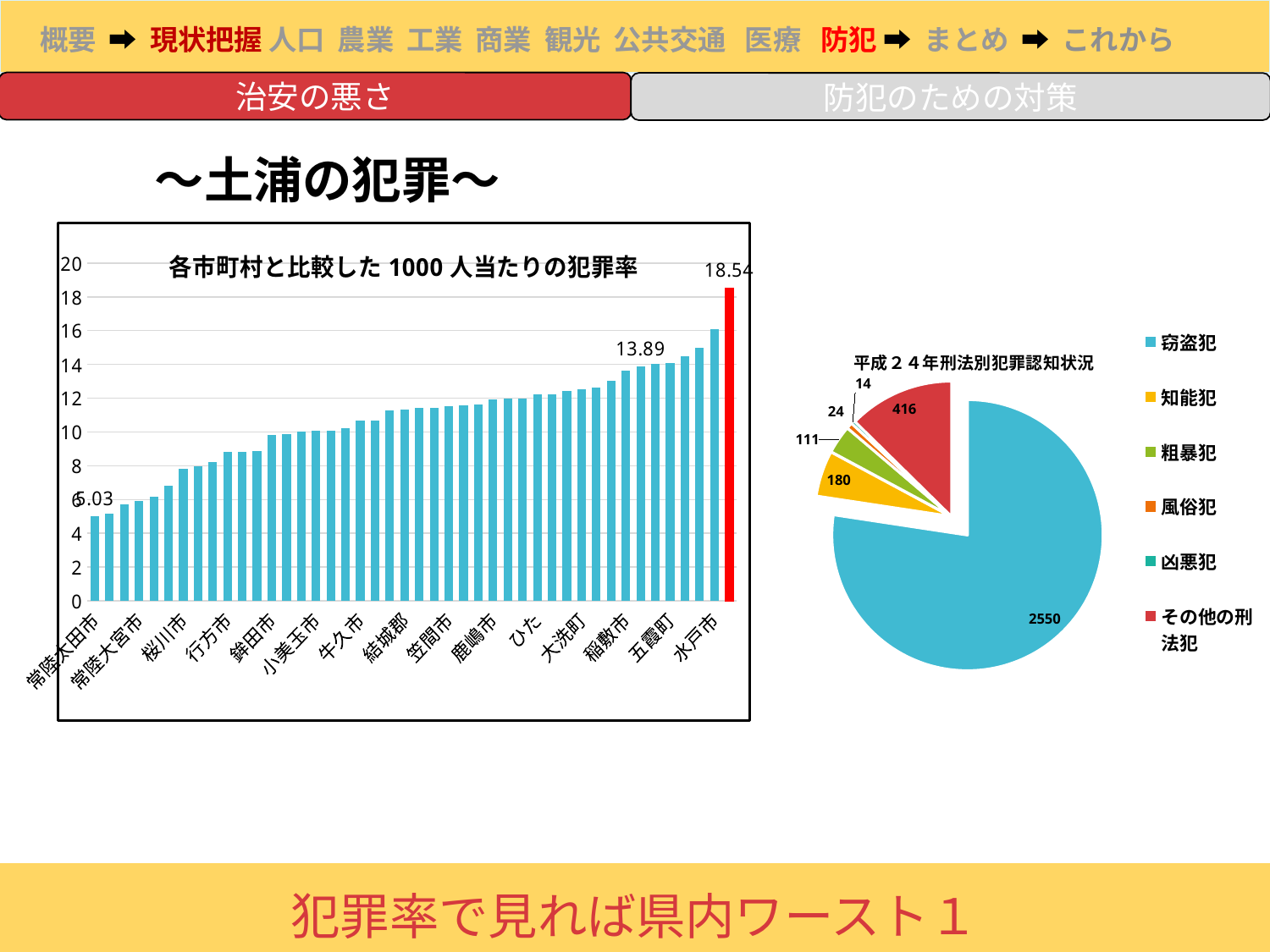
In the bar chart 各市町村と比較した1000人当たりの犯罪率, what is the value of the lowest bar? 5.03 In the pie chart 平成２４年刑法別犯罪認知状況, what is the value for 窃盗犯? 2550 How many categories does the legend of the pie chart 平成２４年刑法別犯罪認知状況 list? 6 In the bar chart 各市町村と比較した1000人当たりの犯罪率, do the values rise or fall from left to right along the x axis? rise In the bar chart 各市町村と比較した1000人当たりの犯罪率, what is the value of the highest bar? 18.54 In the bar chart 各市町村と比較した1000人当たりの犯罪率, what colour is the highest bar? red In the pie chart 平成２４年刑法別犯罪認知状況, which is larger, 粗暴犯 or 風俗犯? 粗暴犯 In the pie chart 平成２４年刑法別犯罪認知状況, which category has the smallest slice? 凶悪犯 In the pie chart 平成２４年刑法別犯罪認知状況, what is the value for 知能犯? 180 In the bar chart 各市町村と比較した1000人当たりの犯罪率, what is the difference between the highest bar (18.54) and the lowest bar (5.03)? 13.51 What kind of chart is the chart titled 各市町村と比較した1000人当たりの犯罪率? bar chart What kind of chart is the chart titled 平成２４年刑法別犯罪認知状況? pie chart